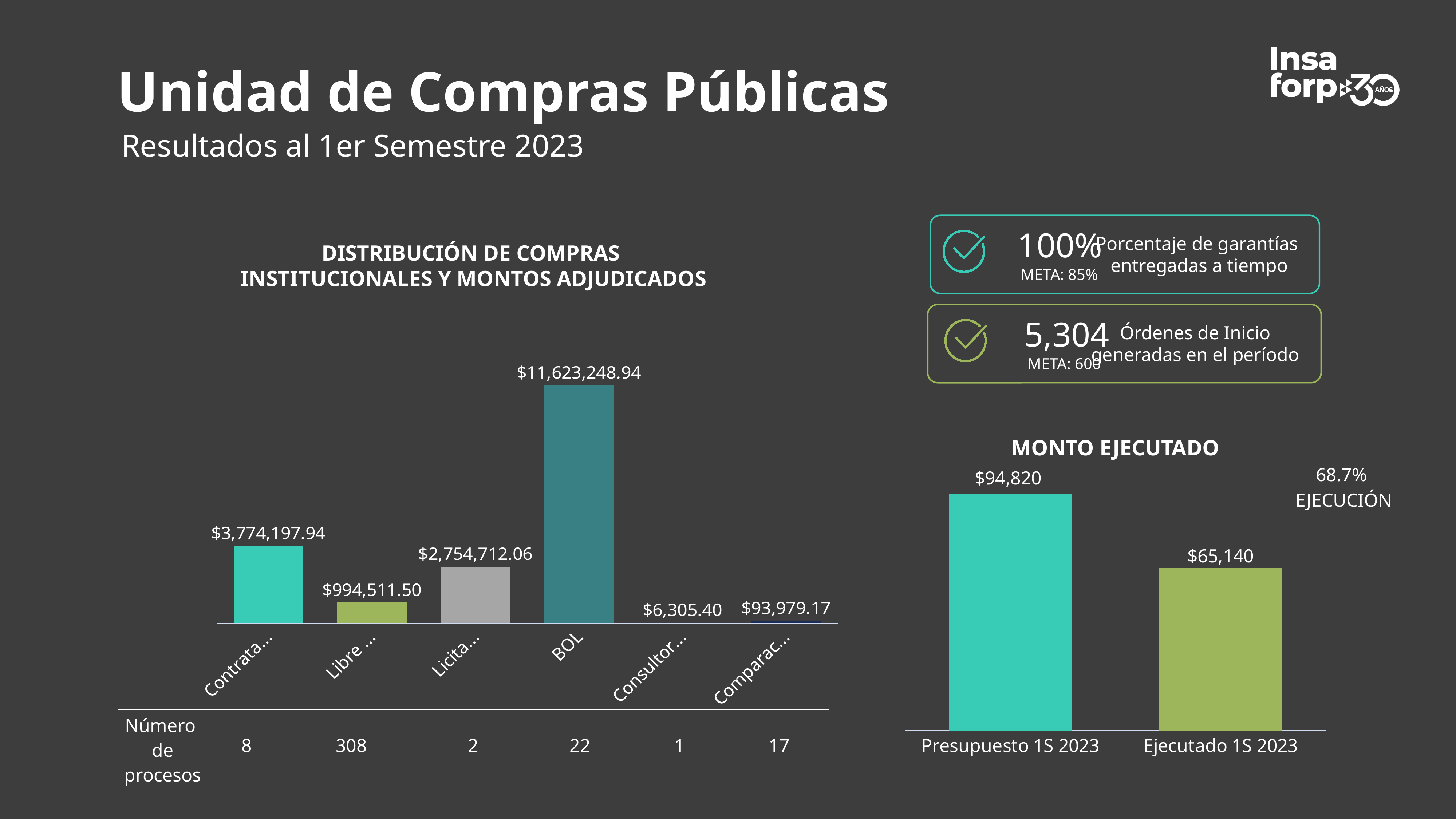
In the DISTRIBUCIÓN DE COMPRAS INSTITUCIONALES Y MONTOS ADJUDICADOS chart, how many categories are plotted? 6 In the DISTRIBUCIÓN DE COMPRAS INSTITUCIONALES Y MONTOS ADJUDICADOS chart, which category has the highest amount? BOL In the MONTO EJECUTADO chart, what is the value for Ejecutado 1S 2023? $65,140 What kind of chart is the MONTO EJECUTADO chart? Bar chart In the MONTO EJECUTADO chart, what is the value for Presupuesto 1S 2023? $94,820 In the MONTO EJECUTADO chart, which is larger, Presupuesto 1S 2023 or Ejecutado 1S 2023? Presupuesto 1S 2023 In the MONTO EJECUTADO chart, what is the difference between Presupuesto 1S 2023 and Ejecutado 1S 2023? $29,680 In the DISTRIBUCIÓN DE COMPRAS INSTITUCIONALES Y MONTOS ADJUDICADOS chart, what is the smallest amount shown? $6,305.40 What kind of chart is the DISTRIBUCIÓN DE COMPRAS INSTITUCIONALES Y MONTOS ADJUDICADOS chart? Bar chart In the DISTRIBUCIÓN DE COMPRAS INSTITUCIONALES Y MONTOS ADJUDICADOS chart, what is the número de procesos for BOL? 22 How many bars does the MONTO EJECUTADO chart show? 2 In the DISTRIBUCIÓN DE COMPRAS INSTITUCIONALES Y MONTOS ADJUDICADOS chart, what is the amount for BOL? $11,623,248.94